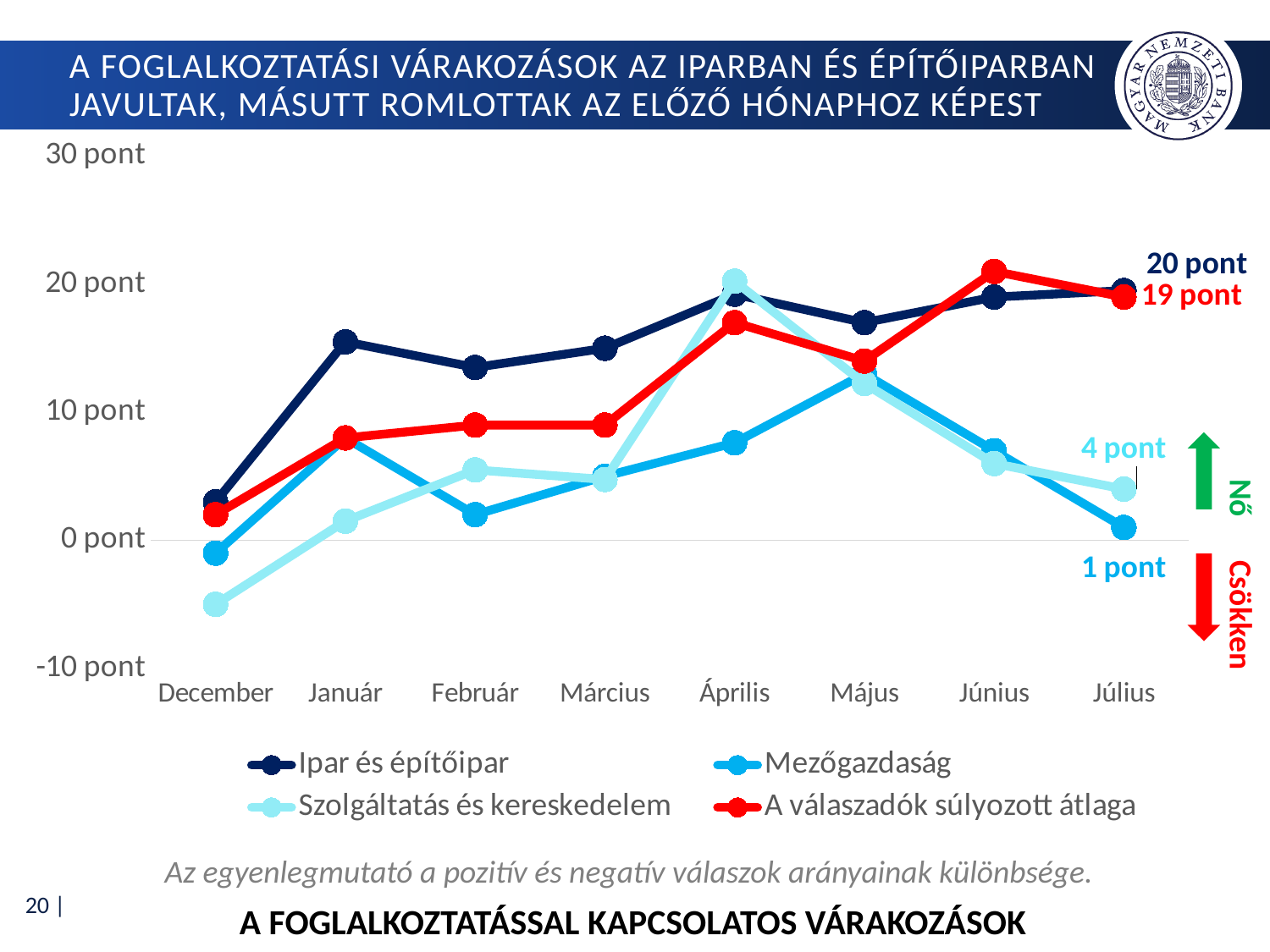
What is the difference between the Július values of Ipar és építőipar and Mezőgazdaság? 19 pont Is the value for Ipar és építőipar in Január greater or less than 10 pont? greater Which is larger in Július: Szolgáltatás és kereskedelem or Mezőgazdaság? Szolgáltatás és kereskedelem What kind of chart is shown on the slide? Line chart What is the value for A válaszadók súlyozott átlaga in Július? 19 pont How many months are shown on the x axis? 8 Is the value for Szolgáltatás és kereskedelem in December greater or less than 0 pont? less How many series does the legend list? 4 What is the value for Szolgáltatás és kereskedelem in Július? 4 pont Which series has the lowest value in Július? Mezőgazdaság What is the value for Mezőgazdaság in Július? 1 pont What is the value for Ipar és építőipar in Július? 20 pont